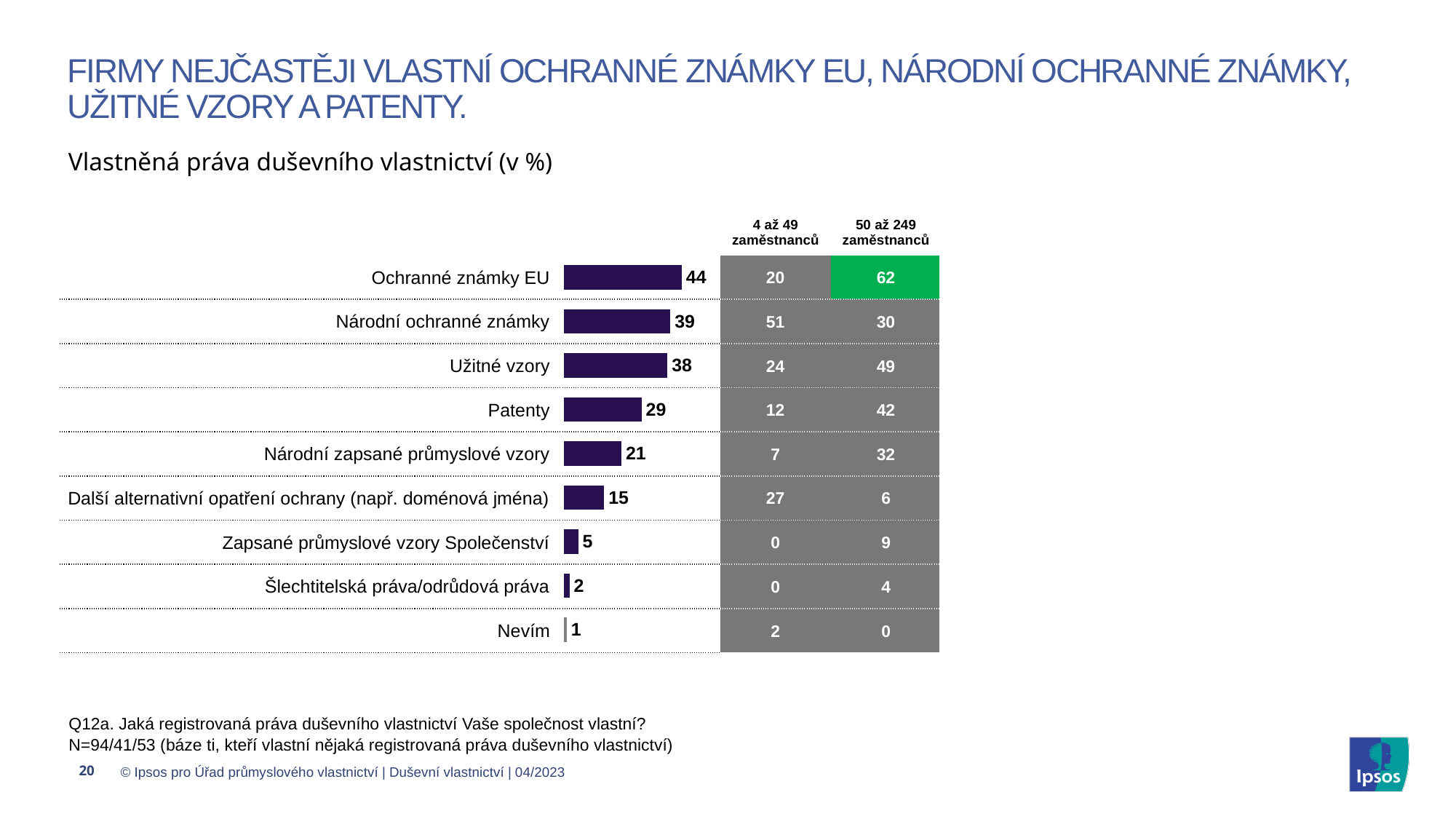
What is the value for Šlechtitelská práva/odrůdová práva in the bar chart? 2 What is the value for Patenty in the bar chart? 29 What is the value for Ochranné známky EU in the bar chart? 44 How many categories are shown in the bar chart? 9 Which is larger, the value for Užitné vzory or the value for Patenty? Užitné vzory What is the value for Další alternativní opatření ochrany (např. doménová jména)? 15 What is the difference between the values for Ochranné známky EU and Národní ochranné známky? 5 Which category has the highest value in the bar chart? Ochranné známky EU What is the subtitle of the chart? Vlastněná práva duševního vlastnictví (v %) What is the difference between the values for Národní zapsané průmyslové vzory and Zapsané průmyslové vzory Společenství? 16 Which category has the lowest value in the bar chart? Nevím What kind of chart is shown on the slide? Bar chart